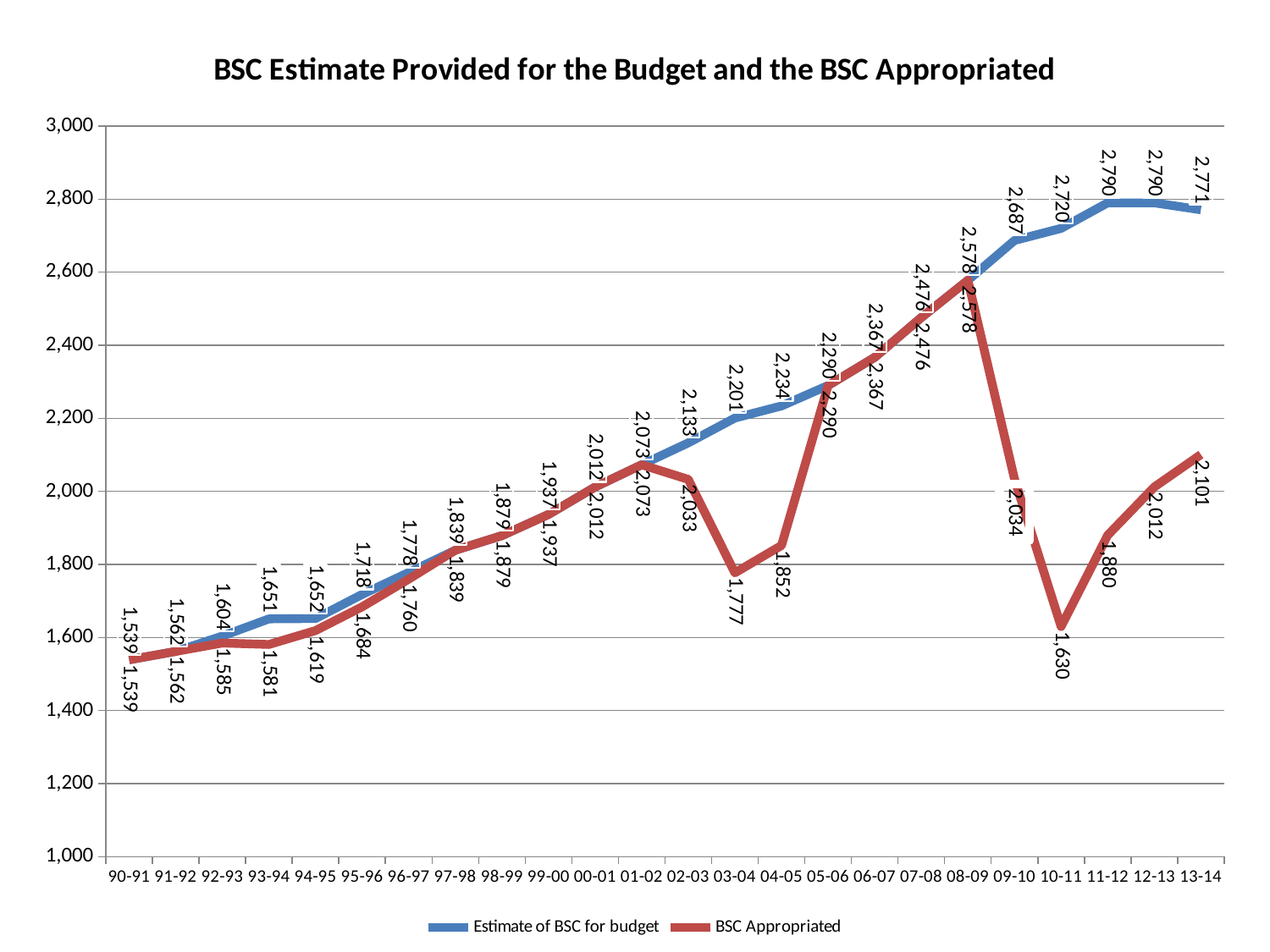
What is the Estimate of BSC for budget value for 13-14? 2,771 In which year is the BSC Appropriated value highest? 08-09 What is the difference between the Estimate of BSC for budget and the BSC Appropriated in 10-11? 1,090 What is the BSC Appropriated value for 10-11? 1,630 In 03-04, which is larger: the Estimate of BSC for budget or the BSC Appropriated? Estimate of BSC for budget What kind of chart is shown on the slide? line chart How many series does the legend list? 2 What colour is the BSC Appropriated line? red In which year is the BSC Appropriated value lowest? 90-91 Does the Estimate of BSC for budget series generally rise or fall from 90-91 to 12-13? rise Is the BSC Appropriated value for 09-10 greater or less than 2,200? less How many fiscal years are shown on the x axis? 24